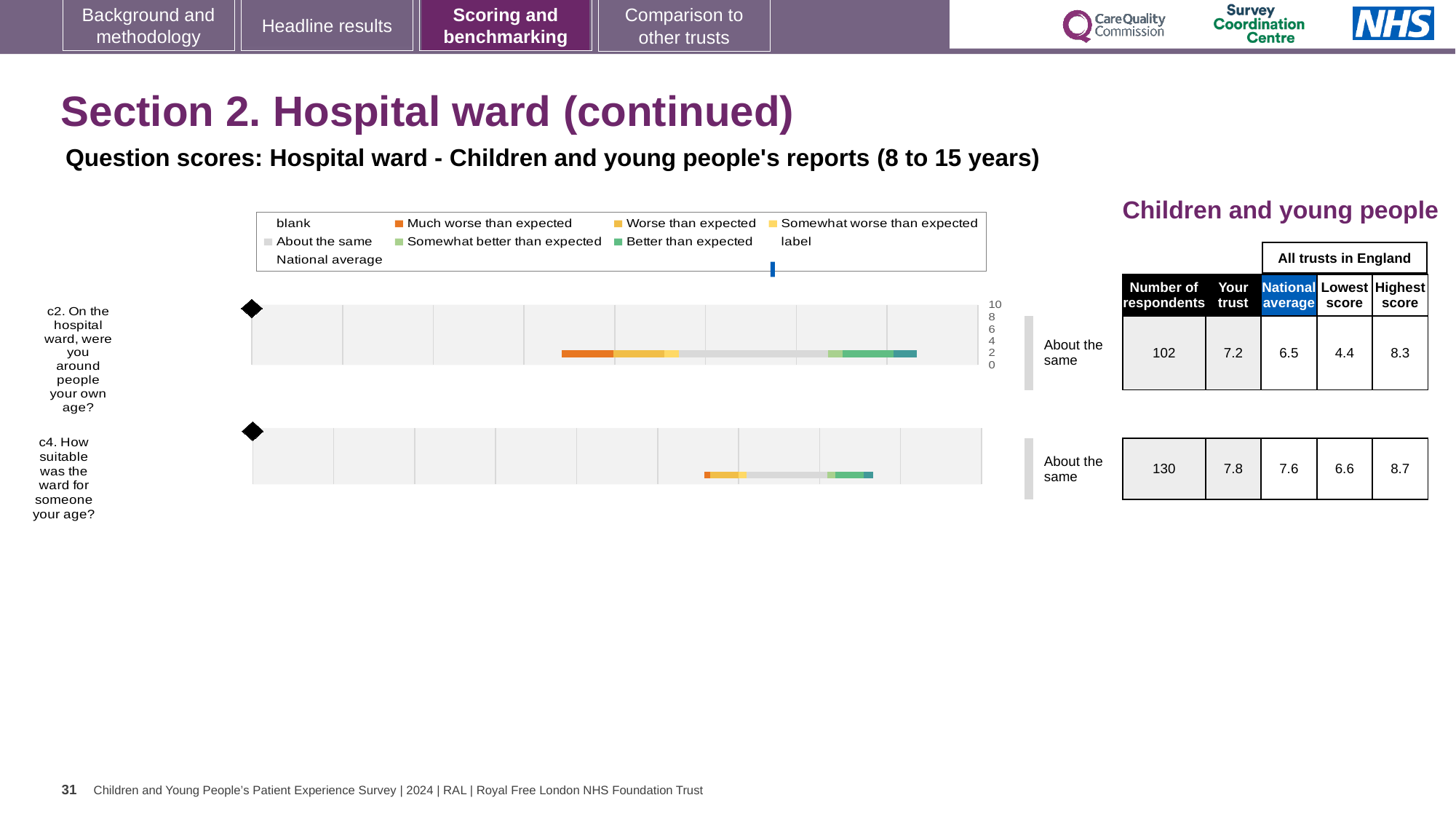
What is the 'Your trust' score for c2 (On the hospital ward, were you around people your own age?)? 7.2 What kind of chart is used to show the question scores for c2 and c4? bar chart What colour represents 'Much worse than expected' in the legend? orange Which question has the higher 'Your trust' score, c2 or c4? c4 What is the lowest score among all trusts in England for c2? 4.4 What is the difference between the highest and lowest scores for c2? 3.9 How many questions are charted on the slide? 2 What is the highest score among all trusts in England for c4? 8.7 What benchmark category is shown for c2? About the same By how much does the trust's score for c4 exceed the national average? 0.2 How many respondents answered question c2? 102 What is the national average score for c4 (How suitable was the ward for someone your age?)? 7.6